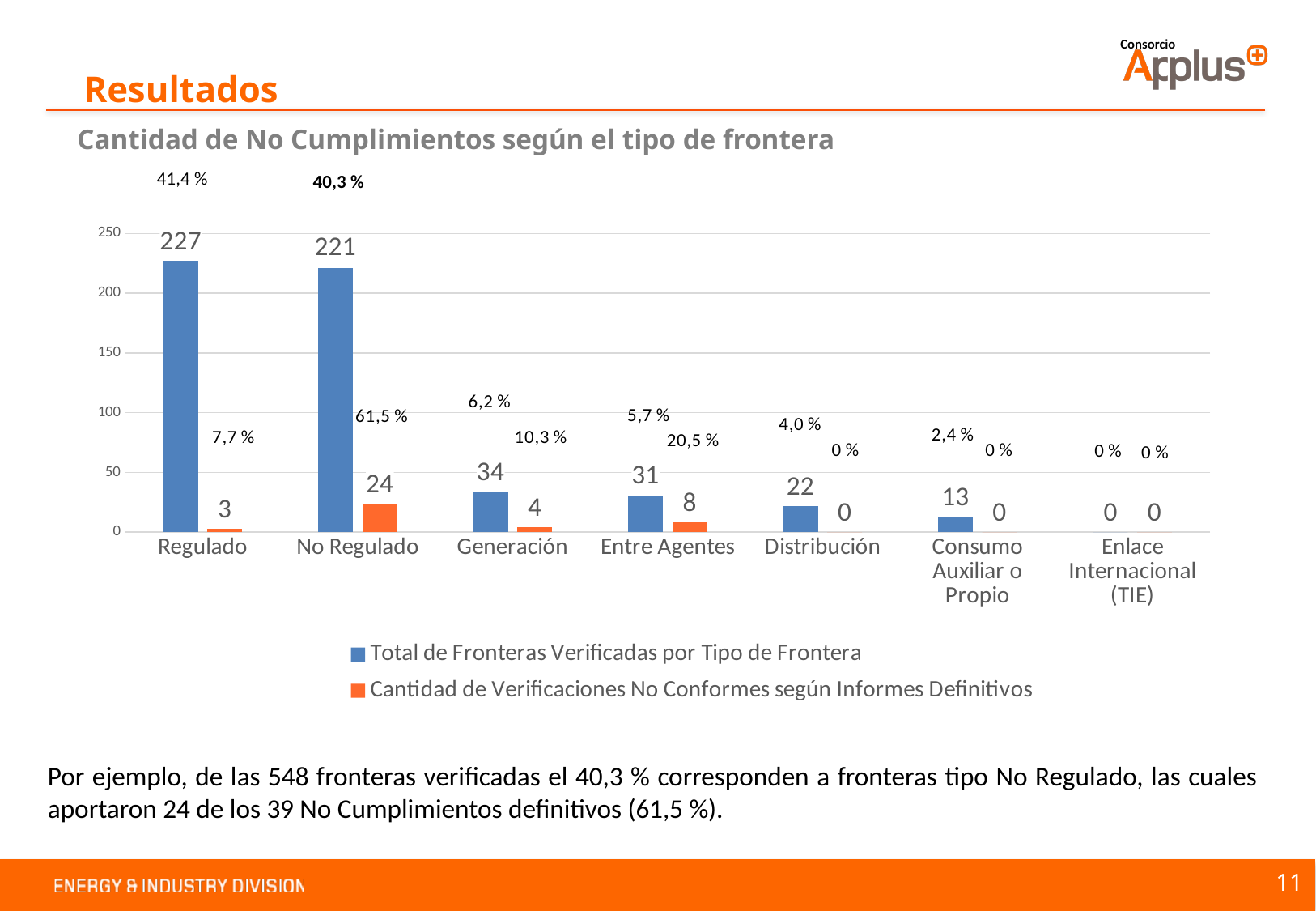
How many series does the legend list? 2 What kind of chart is shown on the slide? bar chart Which is larger: the 'Cantidad de Verificaciones No Conformes' value for Entre Agentes or for Generación? Entre Agentes Which category has the highest value for 'Total de Fronteras Verificadas por Tipo de Frontera'? Regulado What is the difference between the 'Total de Fronteras Verificadas' values for Regulado and No Regulado? 6 What is the title of the chart? Cantidad de No Cumplimientos según el tipo de frontera Is the 'Total de Fronteras Verificadas' value for Generación greater or less than 50? less How many categories are shown on the x axis? 7 What is the value of 'Total de Fronteras Verificadas por Tipo de Frontera' for Regulado? 227 What is the value of 'Cantidad de Verificaciones No Conformes según Informes Definitivos' for No Regulado? 24 Which category has the highest value for 'Cantidad de Verificaciones No Conformes según Informes Definitivos'? No Regulado What is the value of 'Total de Fronteras Verificadas por Tipo de Frontera' for Entre Agentes? 31